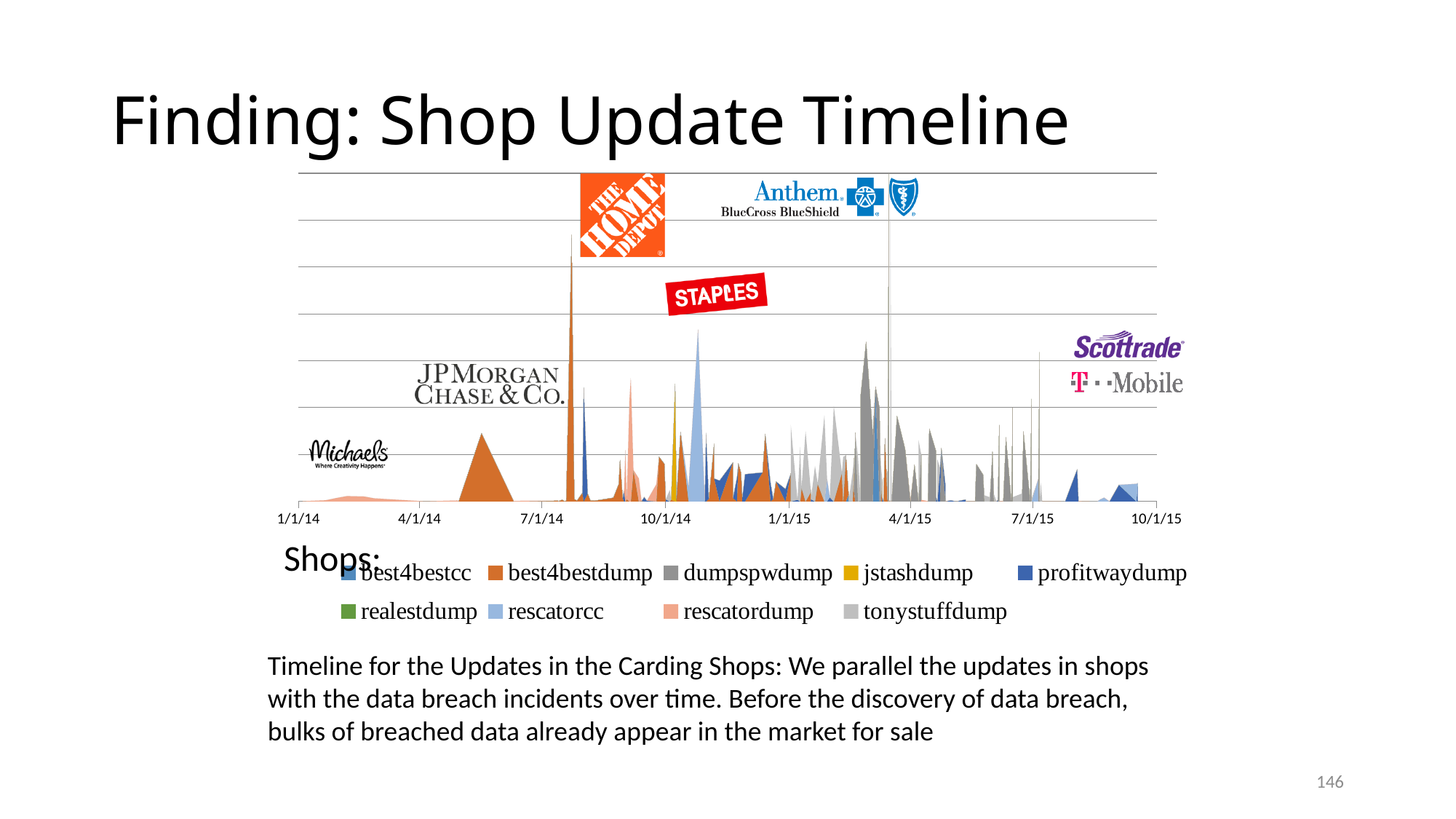
Which series is listed first in the legend? best4bestcc How many date labels are shown along the x axis? 8 How many series does the legend list? 9 Which series is shown in green in the legend? realestdump Which series is listed last in the legend? tonystuffdump What kind of chart is shown on the slide? Area chart Which series has the tallest peak in the chart? best4bestdump